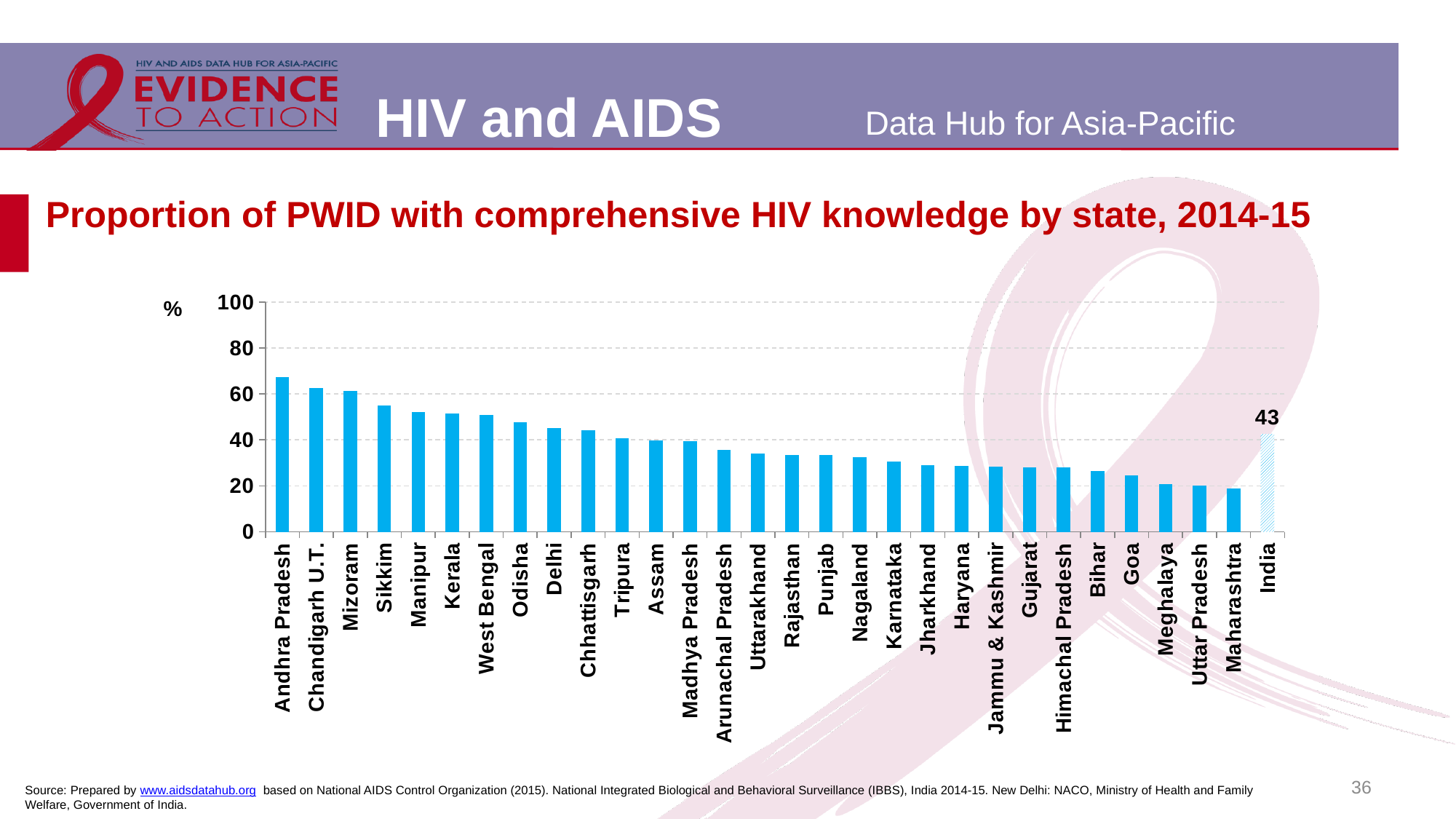
Which state has the lowest proportion of PWID with comprehensive HIV knowledge? Maharashtra What is the value shown for India? 43 Which has a higher value, Mizoram or Goa? Mizoram How many bars are plotted in the chart, including India? 30 Is the value for Delhi greater or less than 40? greater What type of chart is shown on the slide? bar chart Which state has the highest proportion of PWID with comprehensive HIV knowledge? Andhra Pradesh Do the bar values rise or fall from left to right across the states? fall What is the title of the chart? Proportion of PWID with comprehensive HIV knowledge by state, 2014-15 Is the value for Bihar greater or less than 40? less Is the value for Andhra Pradesh greater or less than 60? greater